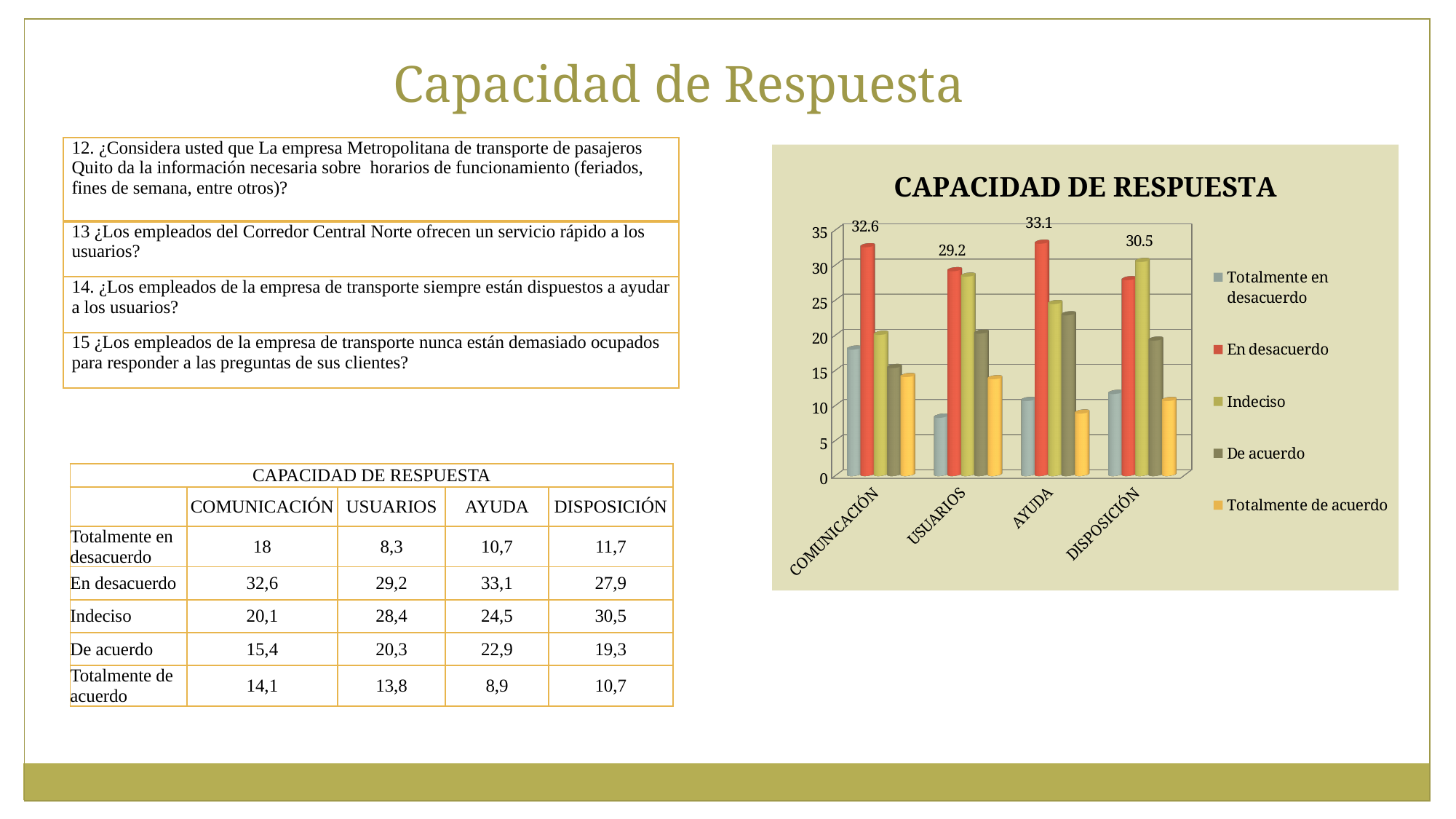
What is the value of En desacuerdo for USUARIOS? 29.2 What is the value of En desacuerdo for AYUDA? 33.1 What is the value of En desacuerdo for COMUNICACIÓN? 32.6 Is the value of Totalmente en desacuerdo for USUARIOS greater or less than 10? less What is the value of Indeciso for DISPOSICIÓN? 30.5 Which has the larger En desacuerdo value, COMUNICACIÓN or USUARIOS? COMUNICACIÓN What is the difference between the En desacuerdo values for AYUDA and COMUNICACIÓN? 0.5 What is the title of the chart? CAPACIDAD DE RESPUESTA How many series does the chart legend list? 5 What kind of chart is shown on the slide? bar chart Which category has the highest En desacuerdo value? AYUDA How many categories are shown on the x axis of the chart? 4